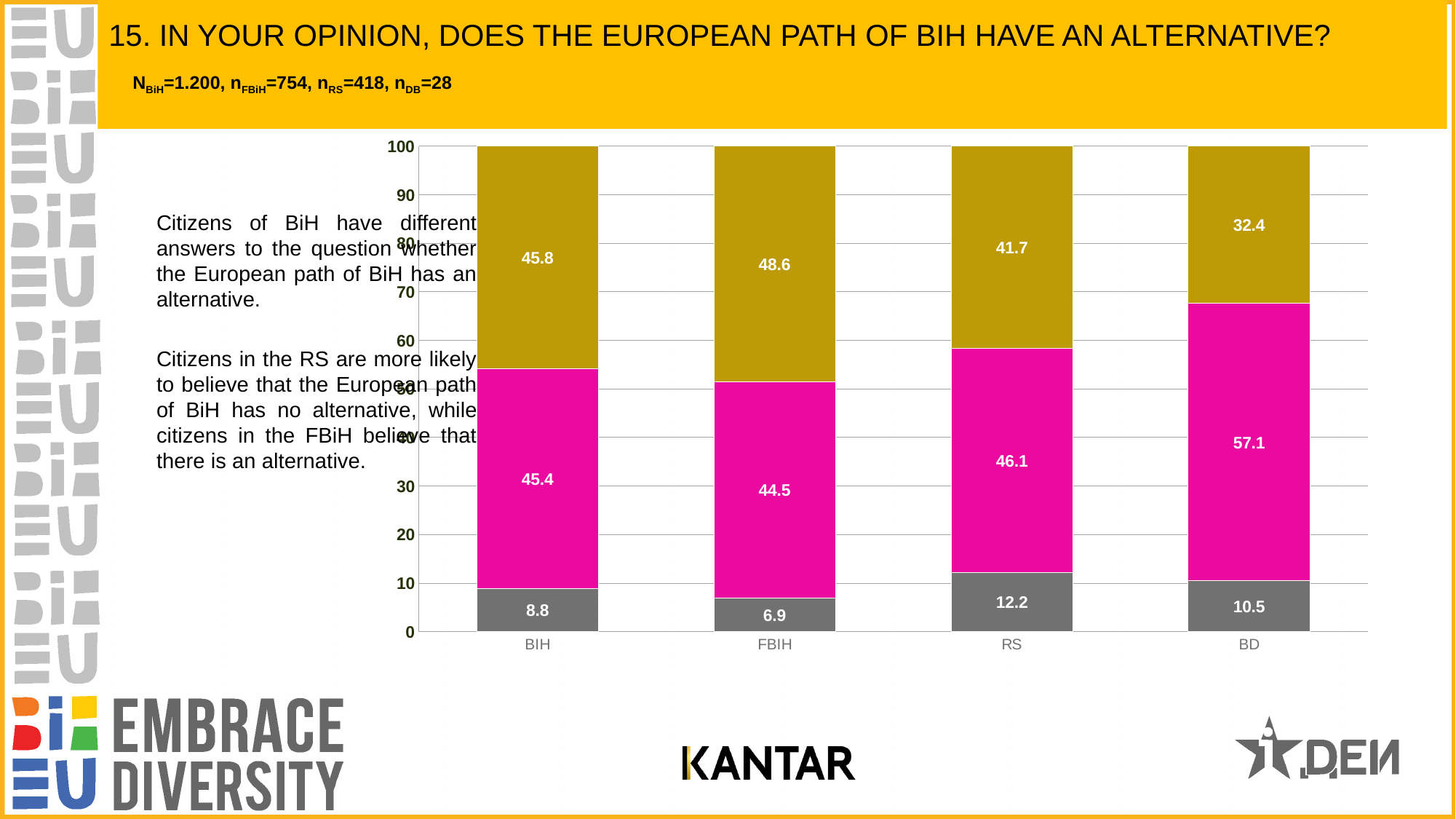
What is the difference between the gold (top) segment values for FBIH and BD? 16.2 Is the gold (top) segment value larger for RS or for FBIH? FBIH What is the total of the stacked bar for RS? 100 What type of chart is shown on the slide? stacked bar chart What is the value of the grey (bottom) segment for BIH? 8.8 What is the value of the gold (top) segment for FBIH? 48.6 How many categories are shown on the x axis of the chart? 4 What is the value of the grey (bottom) segment for RS? 12.2 Which category has the lowest value in the grey (bottom) segment? FBIH Which category has the highest value in the magenta (middle) segment? BD Which category has the lowest value in the gold (top) segment? BD What is the value of the magenta (middle) segment for BD? 57.1